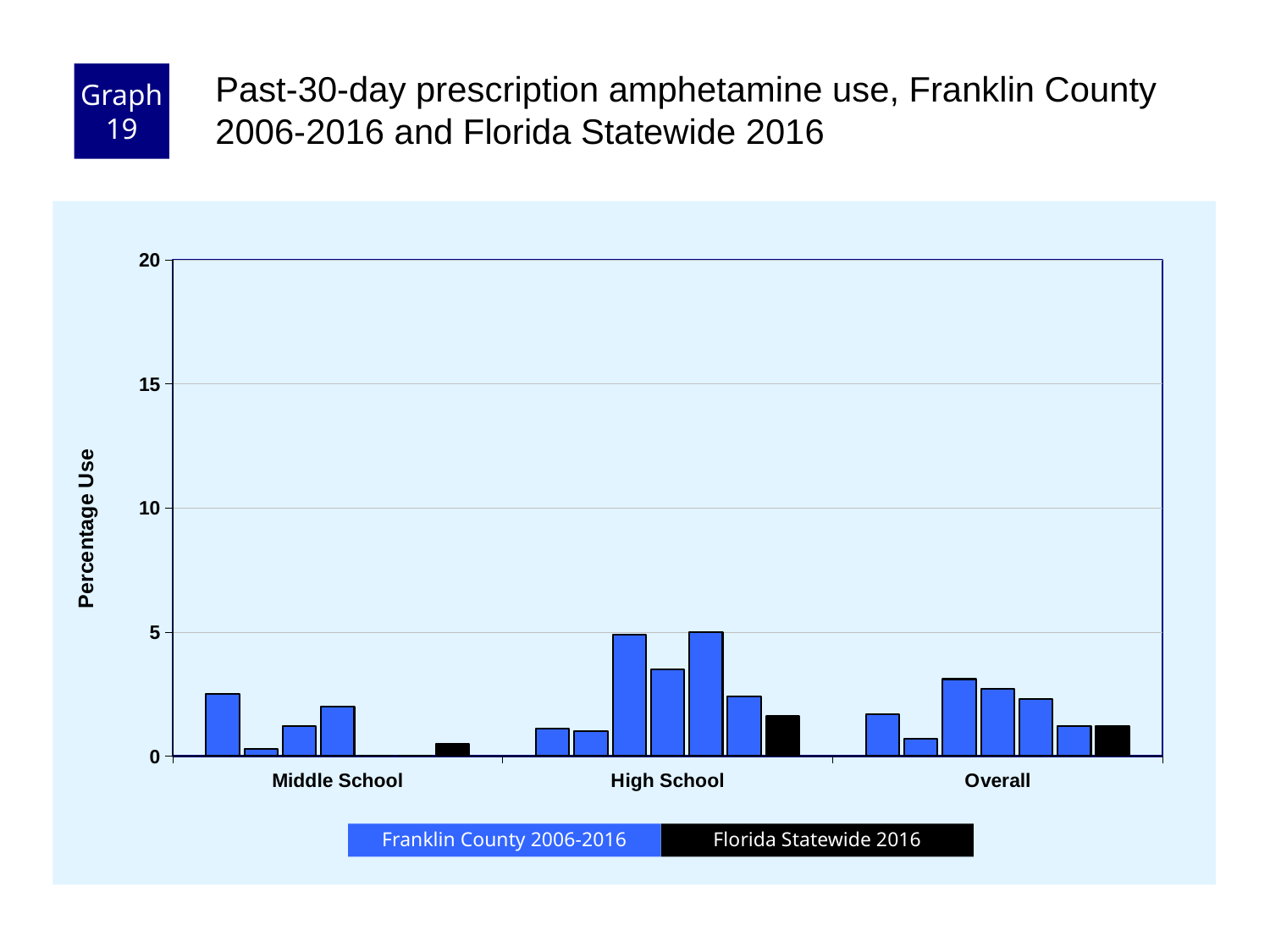
What is the highest value shown on the y axis? 20 Which is larger, the Florida Statewide 2016 value for Overall or for Middle School? Overall How many school-level categories are shown on the x axis? 3 What is the label of the y axis? Percentage Use How many series does the legend list? 2 What kind of chart is shown on the slide? bar chart Which category has the lowest Florida Statewide 2016 value? Middle School Is the Florida Statewide 2016 value for Overall greater or less than 5? less Is the Florida Statewide 2016 value for High School greater or less than 5? less Which is larger, the Florida Statewide 2016 value for High School or for Middle School? High School Which category contains the tallest bar in the chart? High School Is the Florida Statewide 2016 value for Middle School greater or less than 5? less